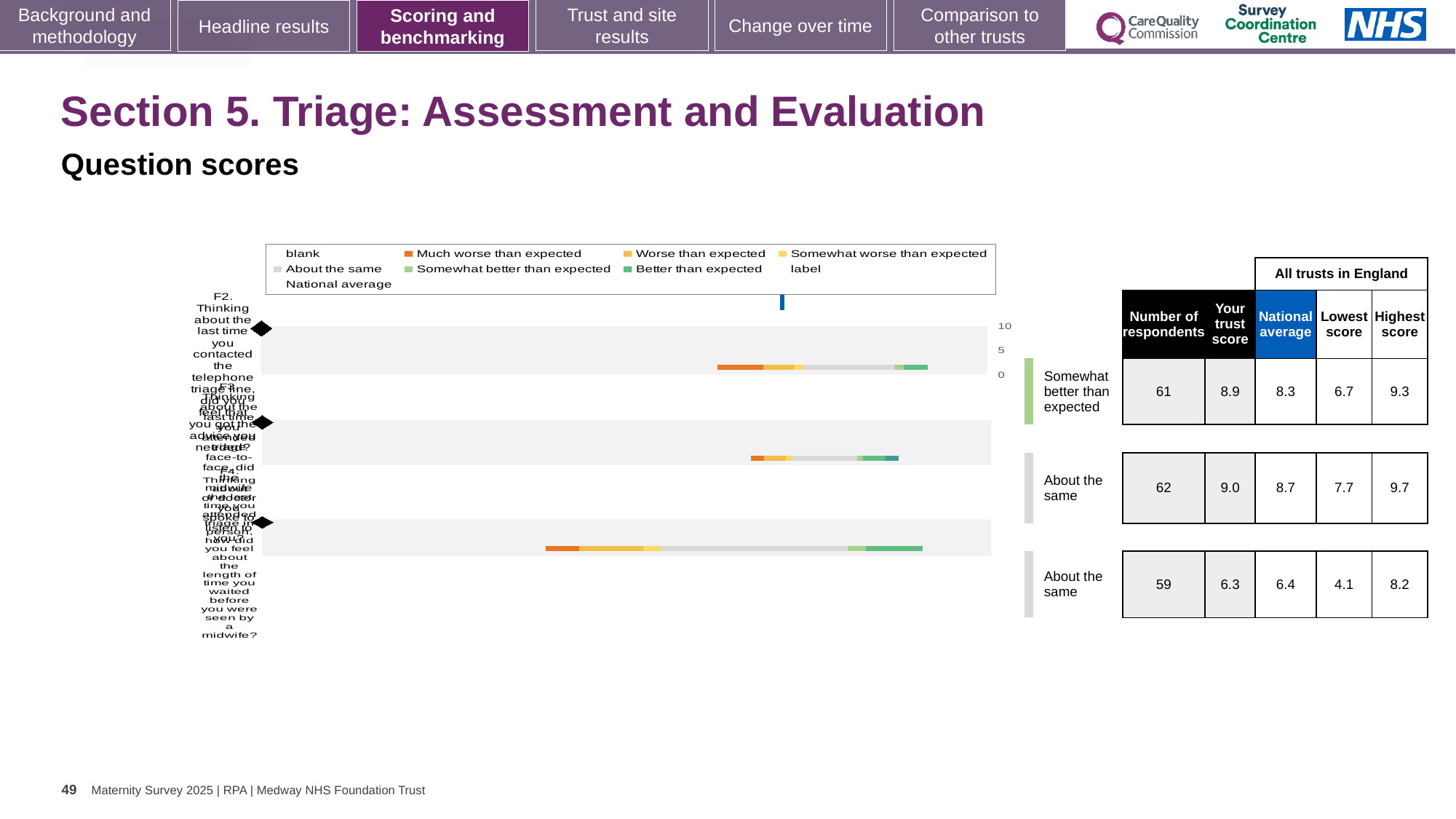
In the table beside the chart, what is the lowest score for the third question (F4)? 4.1 What is the highest tick value shown on the chart's score axis? 10 What is the difference between the trust score and the national average for the first question (F2)? 0.6 Which question has the lowest trust score in the table beside the chart? F4 (6.3) In the table beside the chart, what is the national average for the second question (F3)? 8.7 In the table beside the chart, what is the trust score for the first question (F2)? 8.9 In the table beside the chart, what is the number of respondents for the first question (F2)? 61 What benchmark category is shown for the first question (F2)? Somewhat better than expected How many questions (bars) are plotted in the chart? 3 In the chart legend, what colour represents 'Much worse than expected'? orange What kind of chart is shown on the slide? bar chart Which question has the highest trust score in the table beside the chart? F3 (9.0)